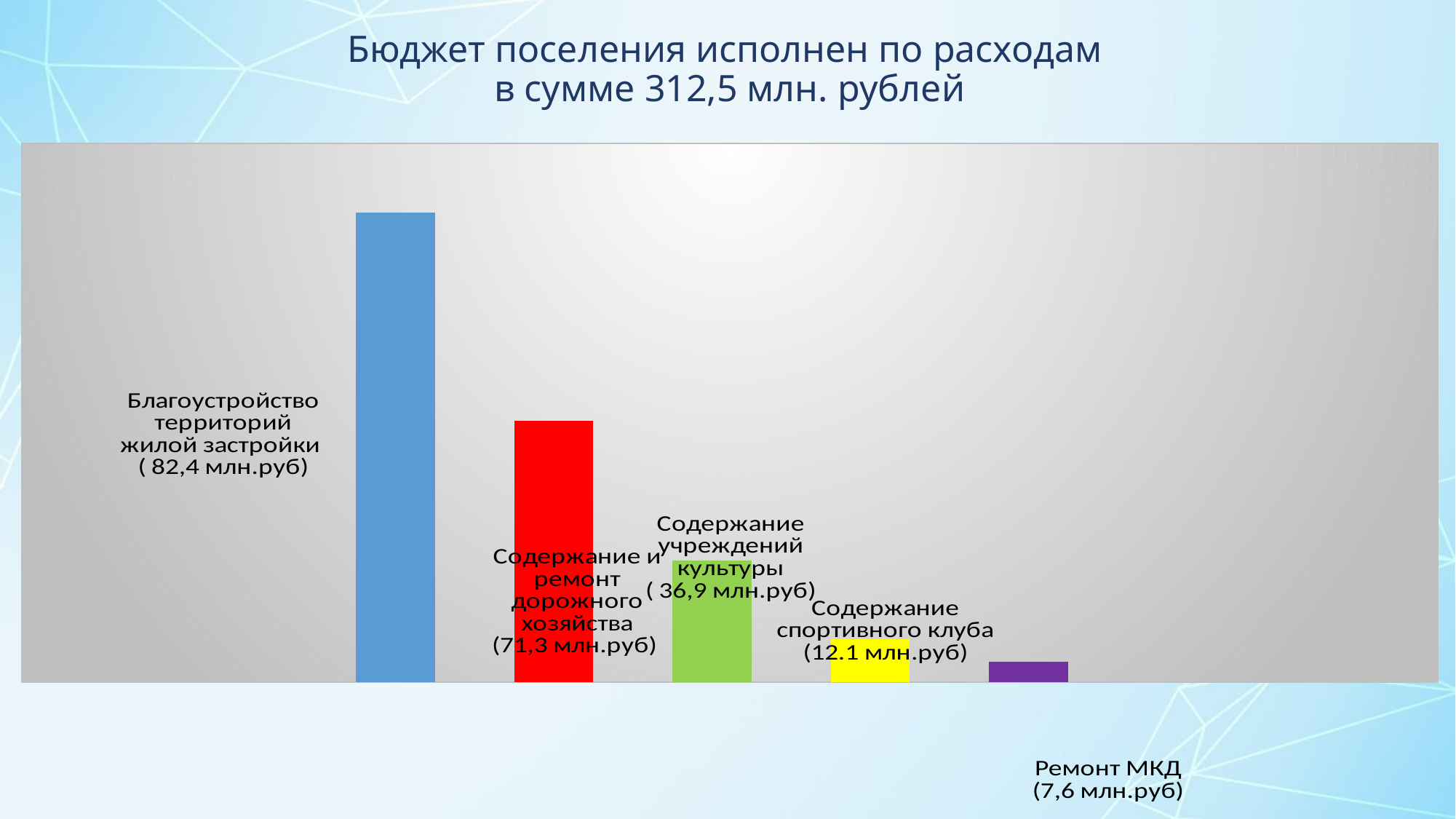
What total expenditure amount is stated in the slide title? 312,5 млн. рублей Which category has the lowest value? Ремонт МКД What is the difference between Содержание учреждений культуры and Содержание спортивного клуба? 24,8 млн.руб Which category has the highest value? Благоустройство территорий жилой застройки What is the value for Содержание учреждений культуры? 36,9 млн.руб What is the value for Благоустройство территорий жилой застройки? 82,4 млн.руб What is the value for Содержание и ремонт дорожного хозяйства? 71,3 млн.руб How many bars (categories) does the chart show? 5 What kind of chart is shown on the slide? Bar chart What is the value for Ремонт МКД? 7,6 млн.руб What is the difference between Благоустройство территорий жилой застройки and Содержание и ремонт дорожного хозяйства? 11,1 млн.руб Which is larger: Содержание спортивного клуба or Ремонт МКД? Содержание спортивного клуба